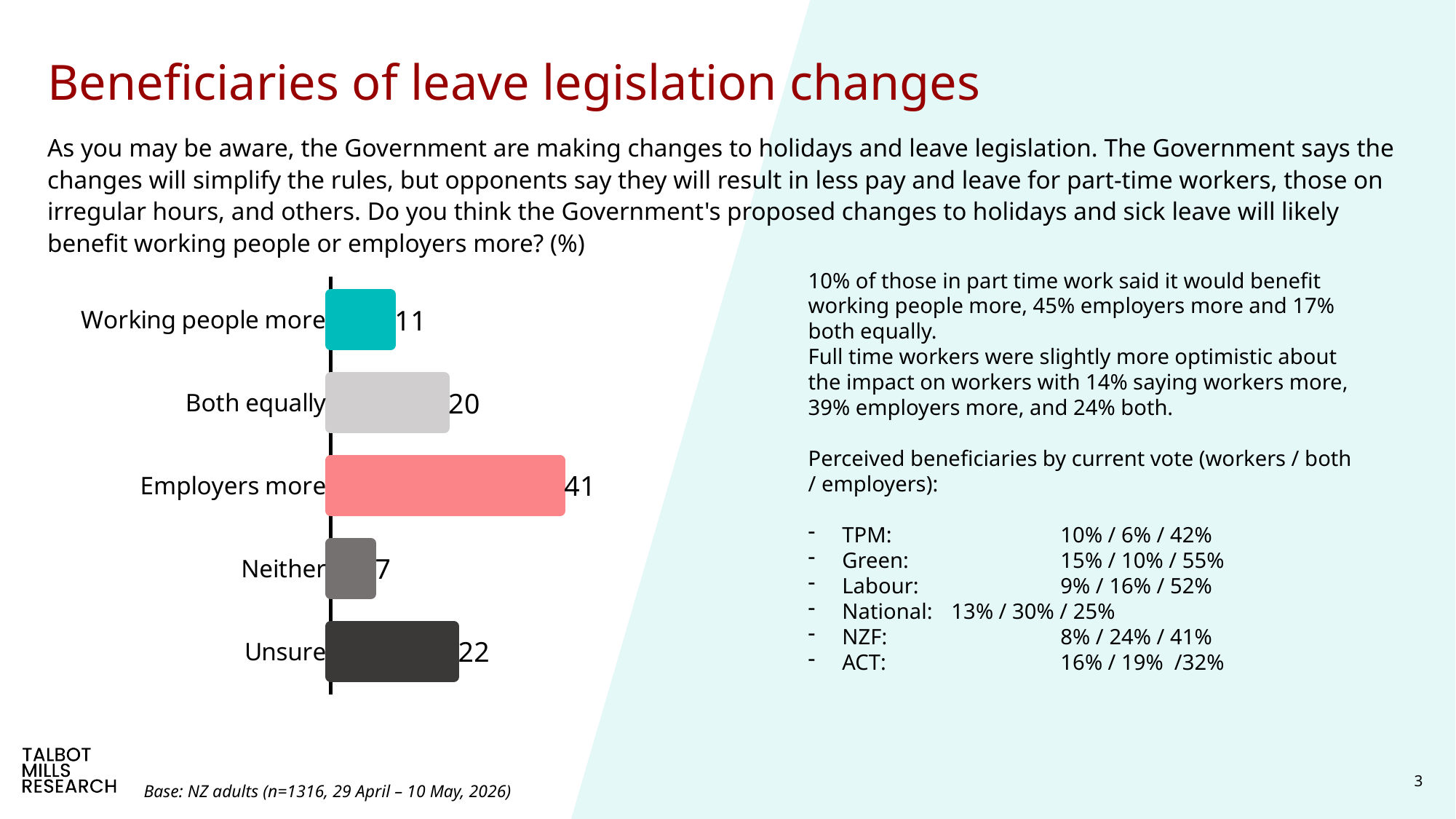
What is the value for Both equally? 20 How many categories are shown in the chart? 5 Which is larger, the value for Both equally or the value for Working people more? Both equally Which category has the highest value? Employers more What is the value for Unsure? 22 What is the difference between the values for Employers more and Working people more? 30 What is the difference between the values for Unsure and Both equally? 2 What kind of chart is shown on the slide? Bar chart What is the value for Working people more? 11 Which category has the lowest value? Neither What is the value for Employers more? 41 What colour is the bar for Employers more? Pink/red